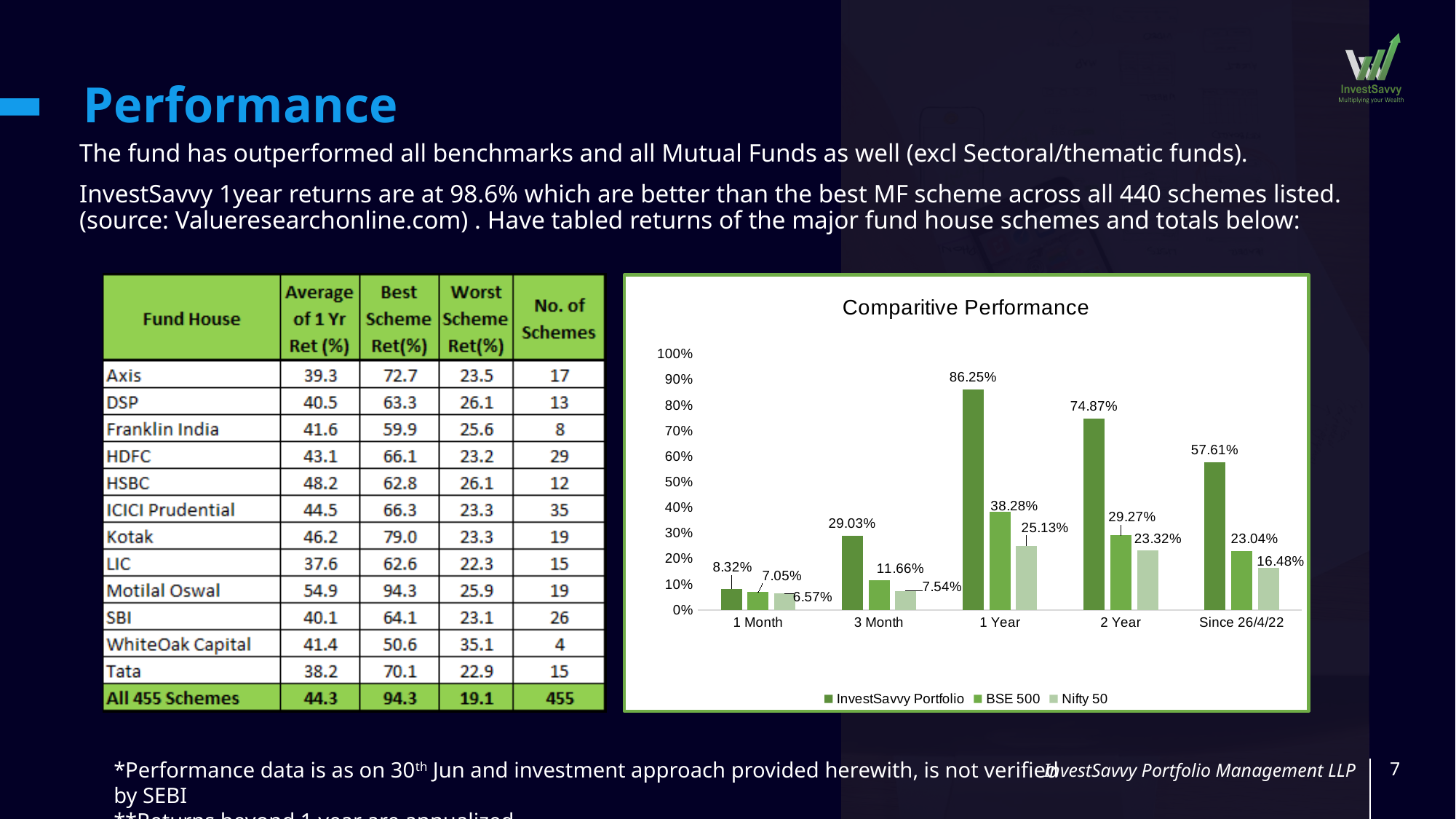
How many series does the legend list? 3 What is the value for Nifty 50 at Since 26/4/22? 16.48% In which period is the Nifty 50 value lowest? 1 Month What is the value for BSE 500 at 3 Month? 11.66% What is the difference between the InvestSavvy Portfolio and BSE 500 values at 2 Year? 45.60% What kind of chart is shown? Bar chart What is the value for the InvestSavvy Portfolio at 1 Year? 86.25% What is the title of the chart? Comparitive Performance How many periods are shown on the x axis? 5 What is the value for Nifty 50 at 1 Month? 6.57% In which period does the InvestSavvy Portfolio reach its highest value? 1 Year Which is larger at 1 Year: BSE 500 or Nifty 50? BSE 500